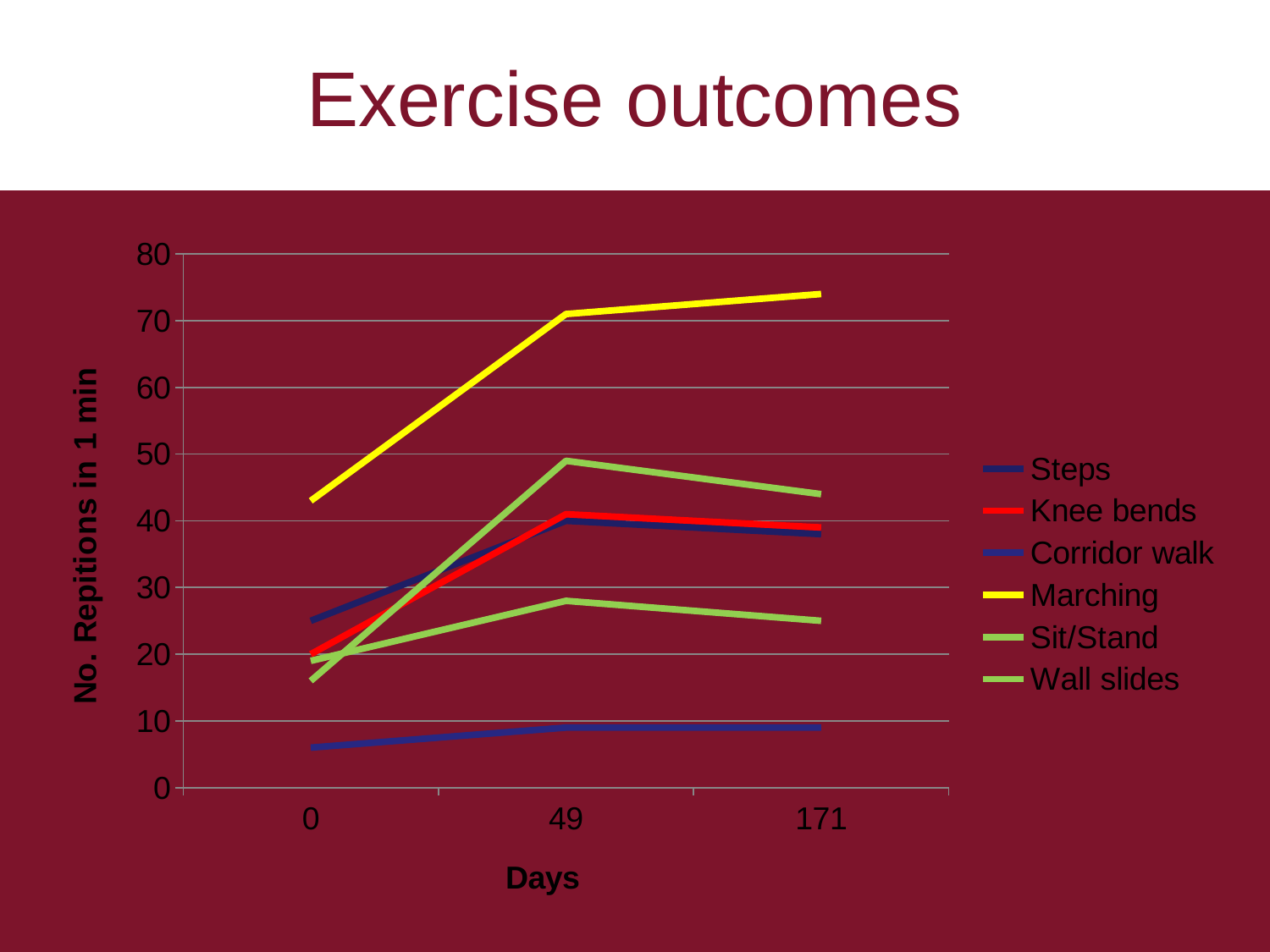
Is the value for Marching at day 171 greater or less than 70? greater At day 49, which is larger: Marching or Knee bends? Marching Is the value for Knee bends at day 49 greater or less than 30? greater Which series has the highest value at day 171? Marching How many points are shown along the Days axis? 3 What kind of chart is shown on the slide? line chart What is the title of the vertical axis? No. Repitions in 1 min How many series does the legend list? 6 Does the Marching line rise or fall from day 0 to day 171? rise Which series has the highest value at day 0? Marching Is the value for Marching at day 0 greater or less than 40? greater